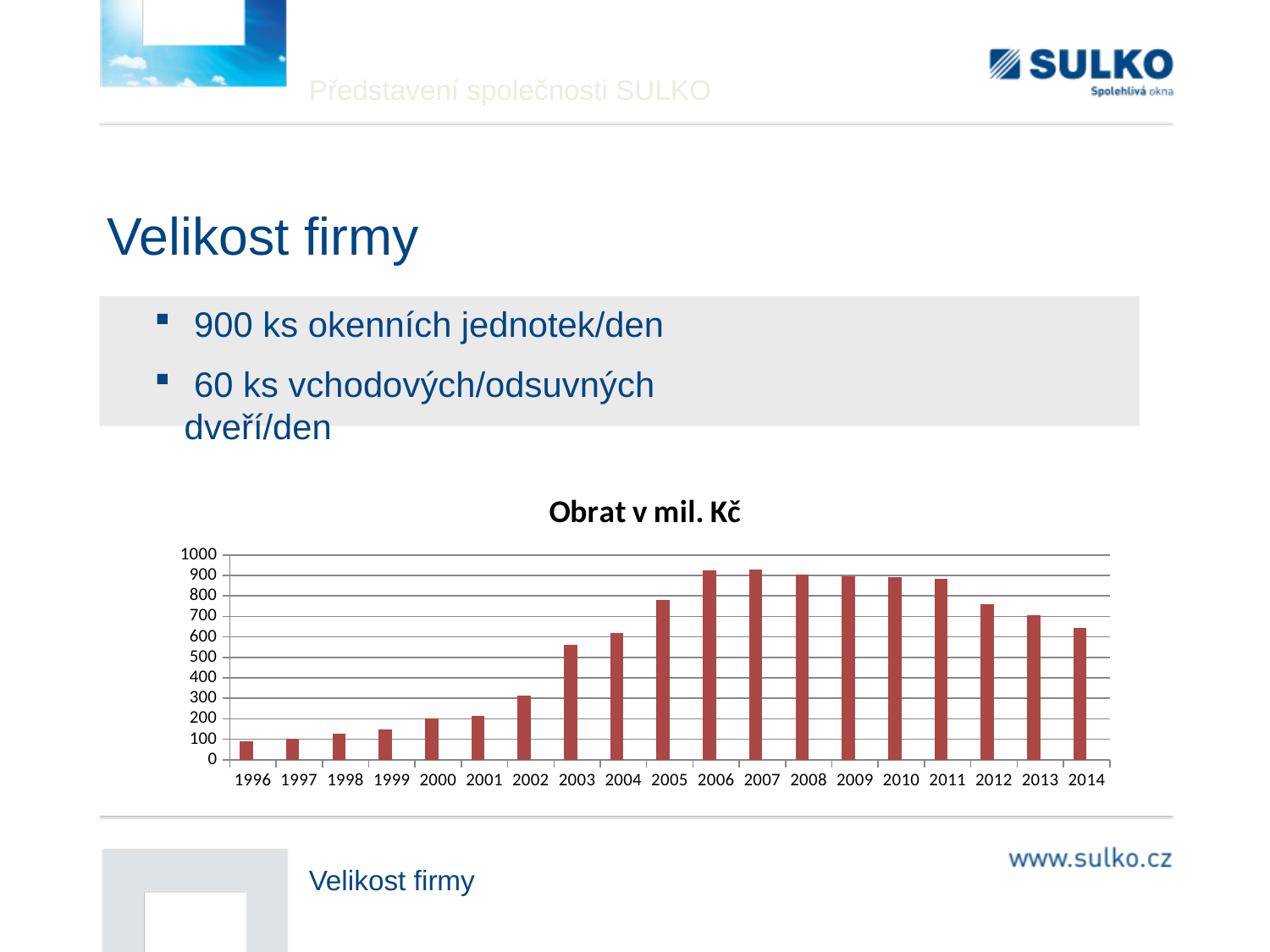
Do the values rise or fall from 2011 to 2014? fall What is the title of the chart? Obrat v mil. Kč What type of chart is shown on the slide? bar chart Which year has the larger value, 2012 or 2014? 2012 Is the value for 2003 greater or less than 500? greater Is the value for 2013 greater or less than 800? less Which year has the larger value, 2003 or 2004? 2004 How many years are shown on the x axis of the chart? 19 Is the value for 2005 greater or less than 700? greater